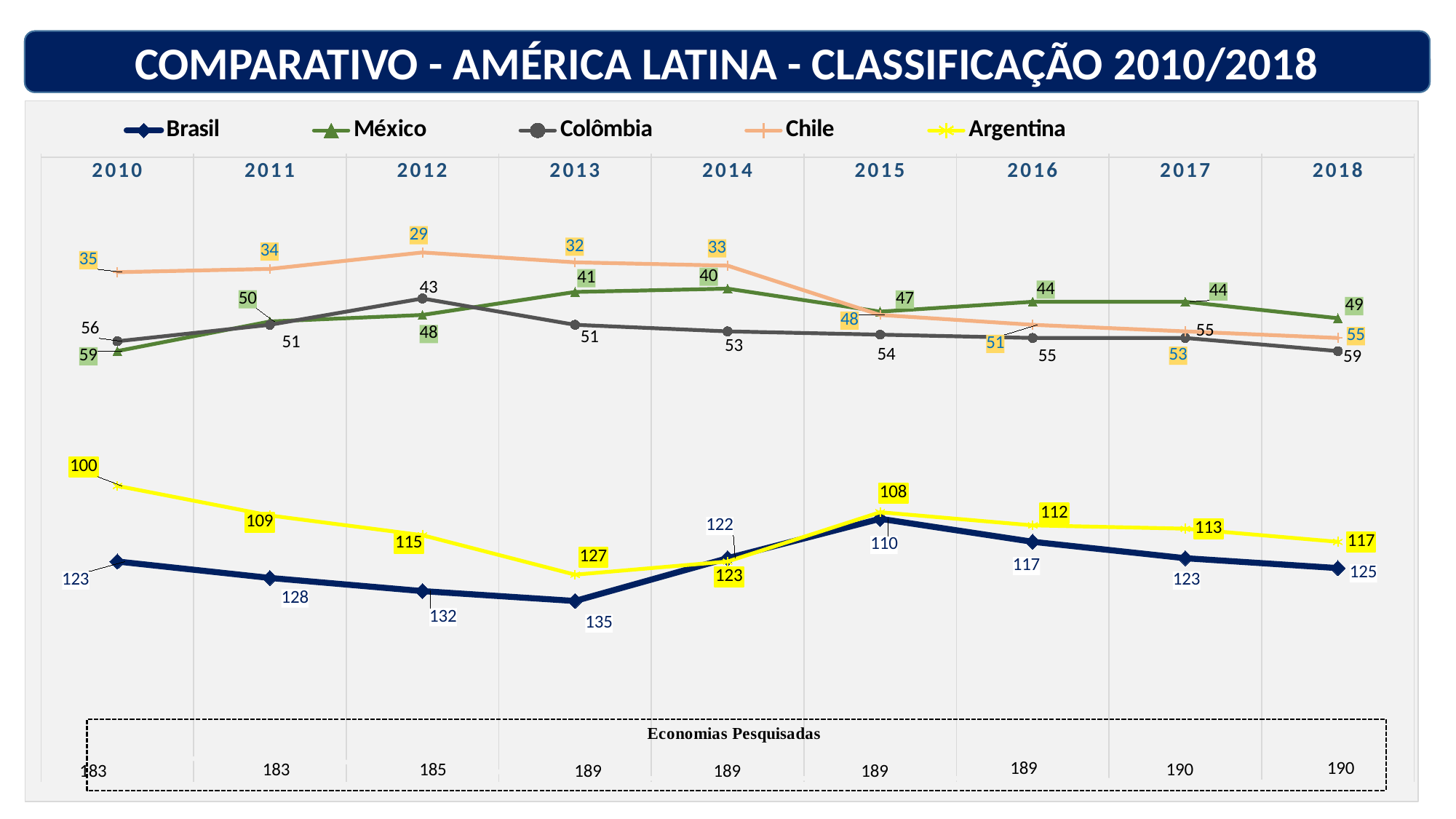
What is the value for Chile in 2012? 29 How many years are plotted along the x axis? 9 What is the value for Brasil in 2013? 135 What is the value for Colômbia in 2018? 59 Which is larger in 2010, the value for México or the value for Colômbia? México In which year does Brasil have its lowest value? 2015 What type of chart is shown on the slide? line chart What is the value for Argentina in 2015? 108 In which year does Argentina have its highest value? 2013 What is the difference between the Brasil value in 2013 and the Brasil value in 2015? 25 How many series does the legend list? 5